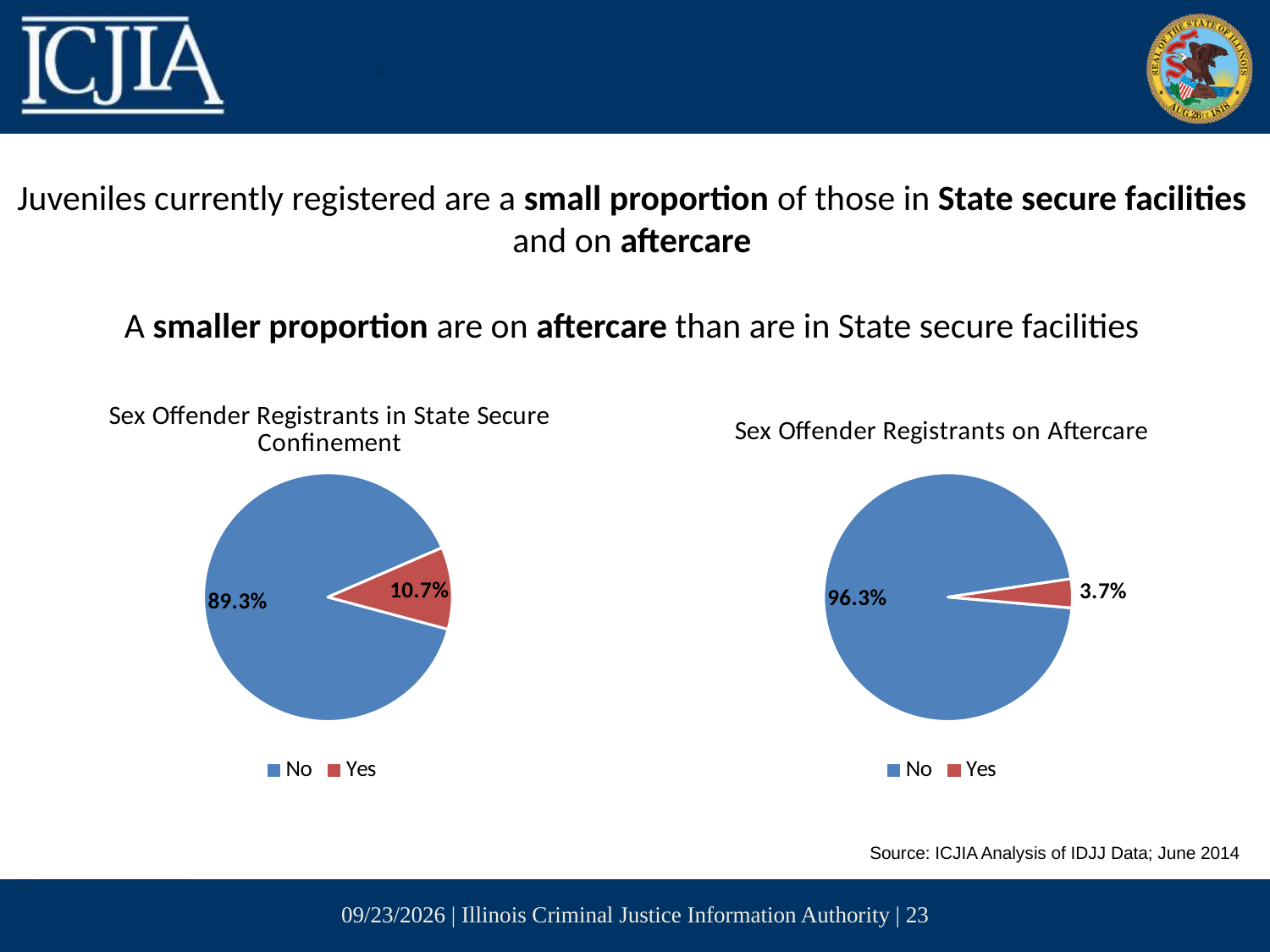
In the 'Sex Offender Registrants in State Secure Confinement' chart, what colour is the 'Yes' slice? Red How many entries does the legend of the 'Sex Offender Registrants on Aftercare' chart list? 2 What type of chart is 'Sex Offender Registrants on Aftercare'? Pie chart In the 'Sex Offender Registrants in State Secure Confinement' chart, what percentage is labelled 'Yes'? 10.7% In the 'Sex Offender Registrants on Aftercare' chart, what percentage is labelled 'No'? 96.3% What is the difference in percentage points between the 'No' and 'Yes' slices in the 'Sex Offender Registrants on Aftercare' chart? 92.6 How many slices does the 'Sex Offender Registrants in State Secure Confinement' pie chart have? 2 In the 'Sex Offender Registrants in State Secure Confinement' chart, which slice is the largest? No Which is larger: the 'Yes' share in the 'Sex Offender Registrants in State Secure Confinement' chart or the 'Yes' share in the 'Sex Offender Registrants on Aftercare' chart? State Secure Confinement In the 'Sex Offender Registrants on Aftercare' chart, what percentage is labelled 'Yes'? 3.7% In the 'Sex Offender Registrants on Aftercare' chart, which slice is the smallest? Yes In the 'Sex Offender Registrants in State Secure Confinement' chart, what percentage is labelled 'No'? 89.3%